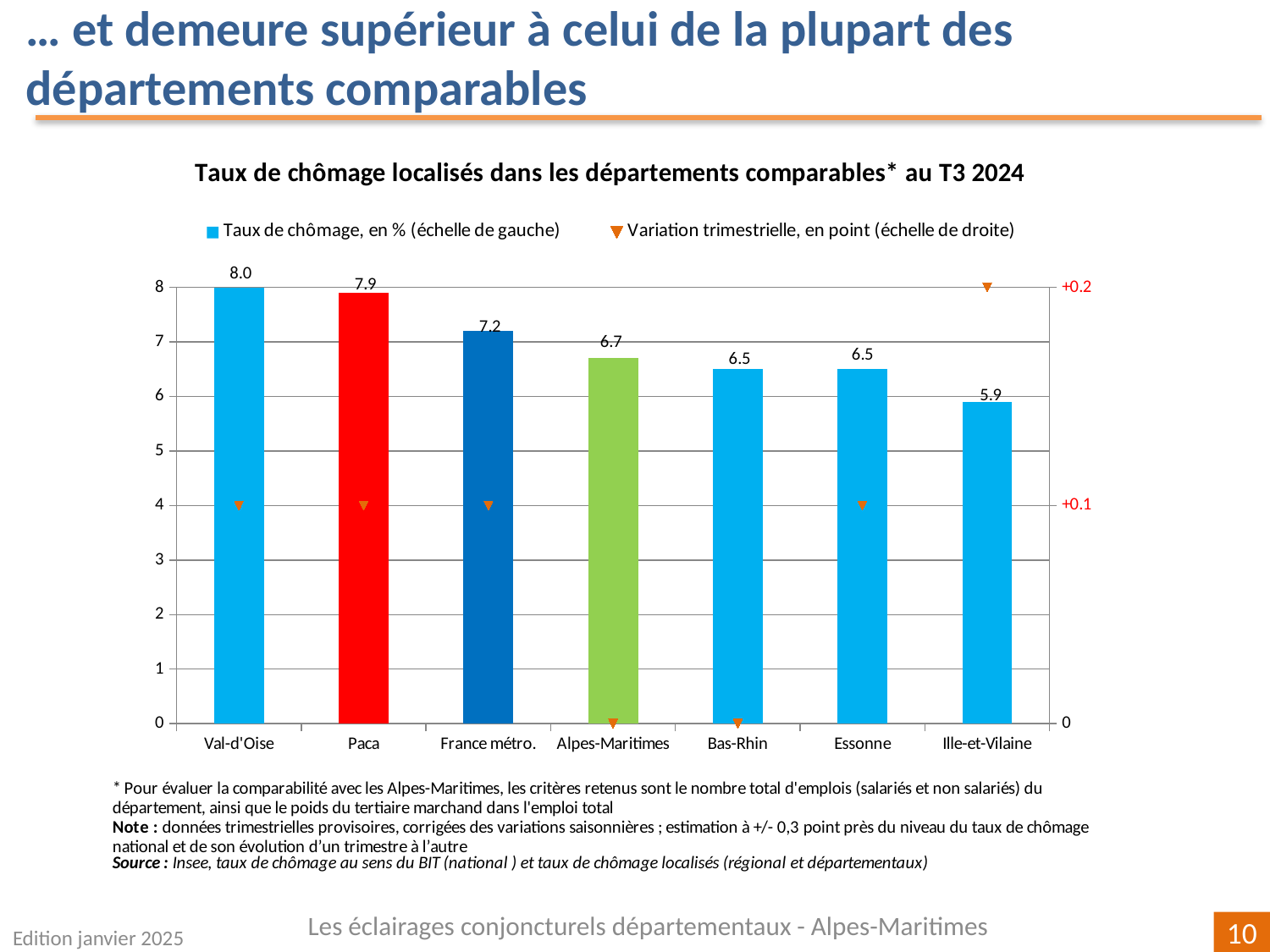
What is the unemployment rate shown for Alpes-Maritimes? 6.7 What is the unemployment rate shown for Ille-et-Vilaine? 5.9 What is the difference between the unemployment rate of Val-d'Oise and that of Alpes-Maritimes? 1.3 How many departments or areas are shown on the x axis? 7 What kind of chart is used to show the unemployment rates? Bar chart Which has a higher unemployment rate, Paca or France métro.? Paca What is the quarterly variation shown for Alpes-Maritimes on the right-hand scale? 0 Which department has the lowest unemployment rate on the chart? Ille-et-Vilaine How many series does the legend list? 2 What is the unemployment rate (Taux de chômage) for Val-d'Oise? 8.0 What is the quarterly variation (Variation trimestrielle) shown for Ille-et-Vilaine on the right-hand scale? +0.2 Which department has the highest unemployment rate on the chart? Val-d'Oise